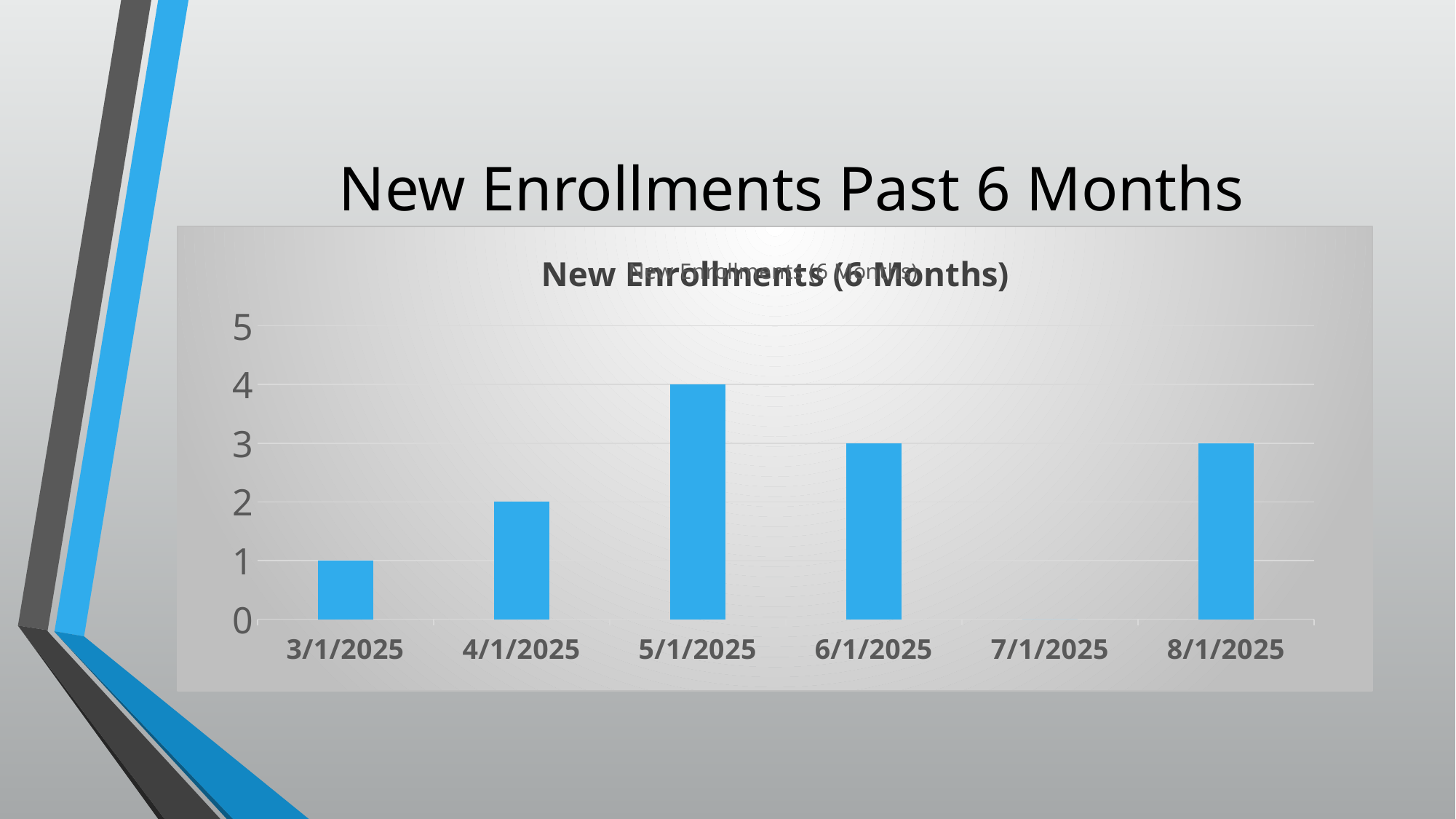
Do the values rise or fall from 3/1/2025 to 5/1/2025? rise What is the value for 3/1/2025? 1 Which category has the highest value? 5/1/2025 What is the title of the chart? New Enrollments (6 Months) What kind of chart is shown on the slide? bar chart Which is larger, the value for 6/1/2025 or the value for 4/1/2025? 6/1/2025 What is the value for 7/1/2025? 0 How many categories are shown on the x axis of the chart? 6 What is the value for 5/1/2025? 4 What is the difference between the values for 5/1/2025 and 4/1/2025? 2 Which category has the lowest value? 7/1/2025 What is the value for 8/1/2025? 3